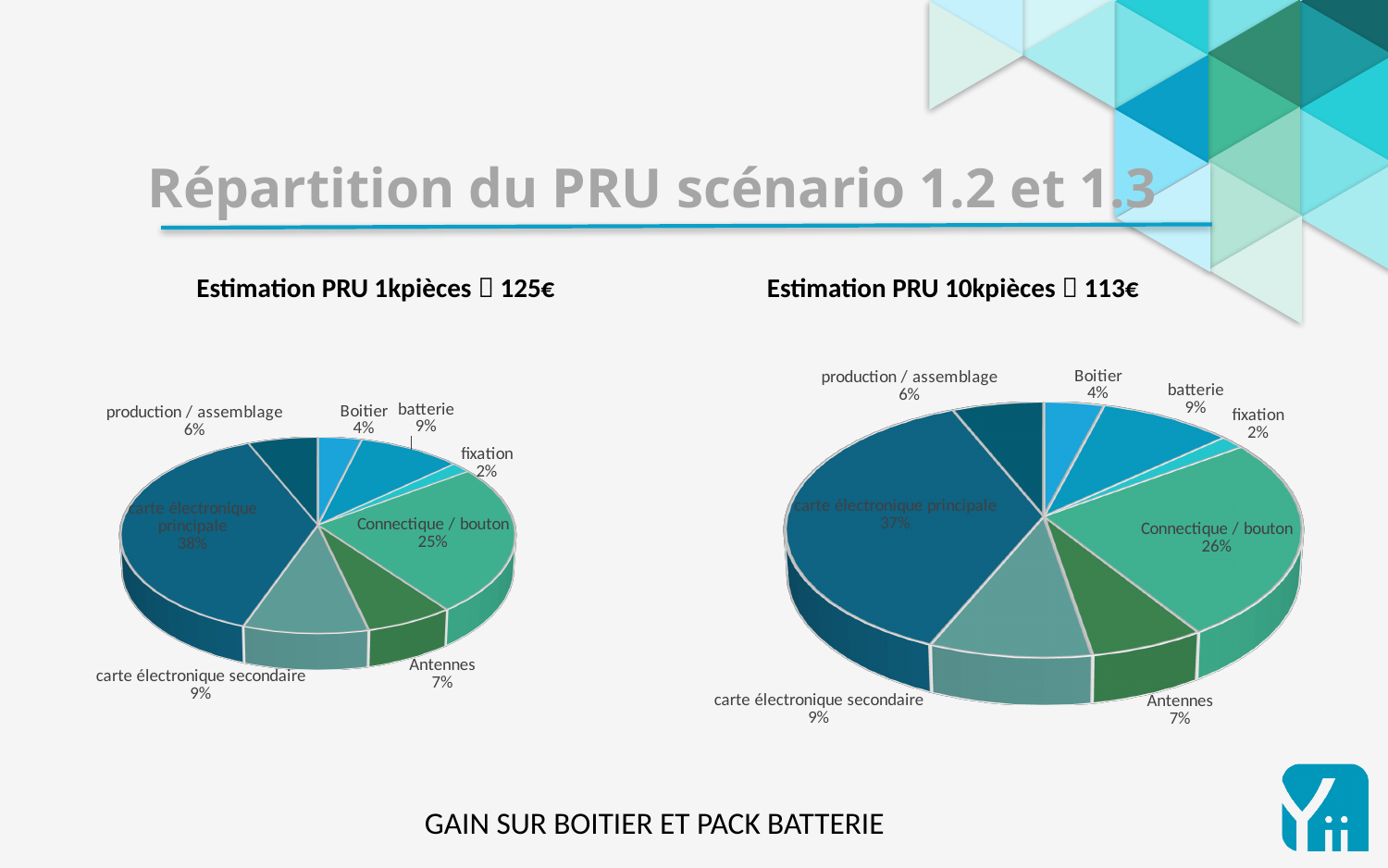
What type of chart is used on this slide? pie chart What is the title of the right pie chart? Estimation PRU 10kpièces 113€ In the left pie chart, what is the difference in percentage points between 'carte électronique principale' and 'Connectique / bouton'? 13 In the left pie chart, what share does 'fixation' have? 2% In the left pie chart, which category has the largest share? carte électronique principale In the right pie chart (Estimation PRU 10kpièces), what share does 'carte électronique principale' have? 37% In the right pie chart, which is larger: 'batterie' or 'Antennes'? batterie In the right pie chart, which category has the smallest share? fixation In the right pie chart, what share does 'Connectique / bouton' have? 26% In the right pie chart, what share does 'Boitier' have? 4% In the left pie chart (Estimation PRU 1kpièces), what share does 'Connectique / bouton' have? 25% How many slices does the left pie chart have? 8